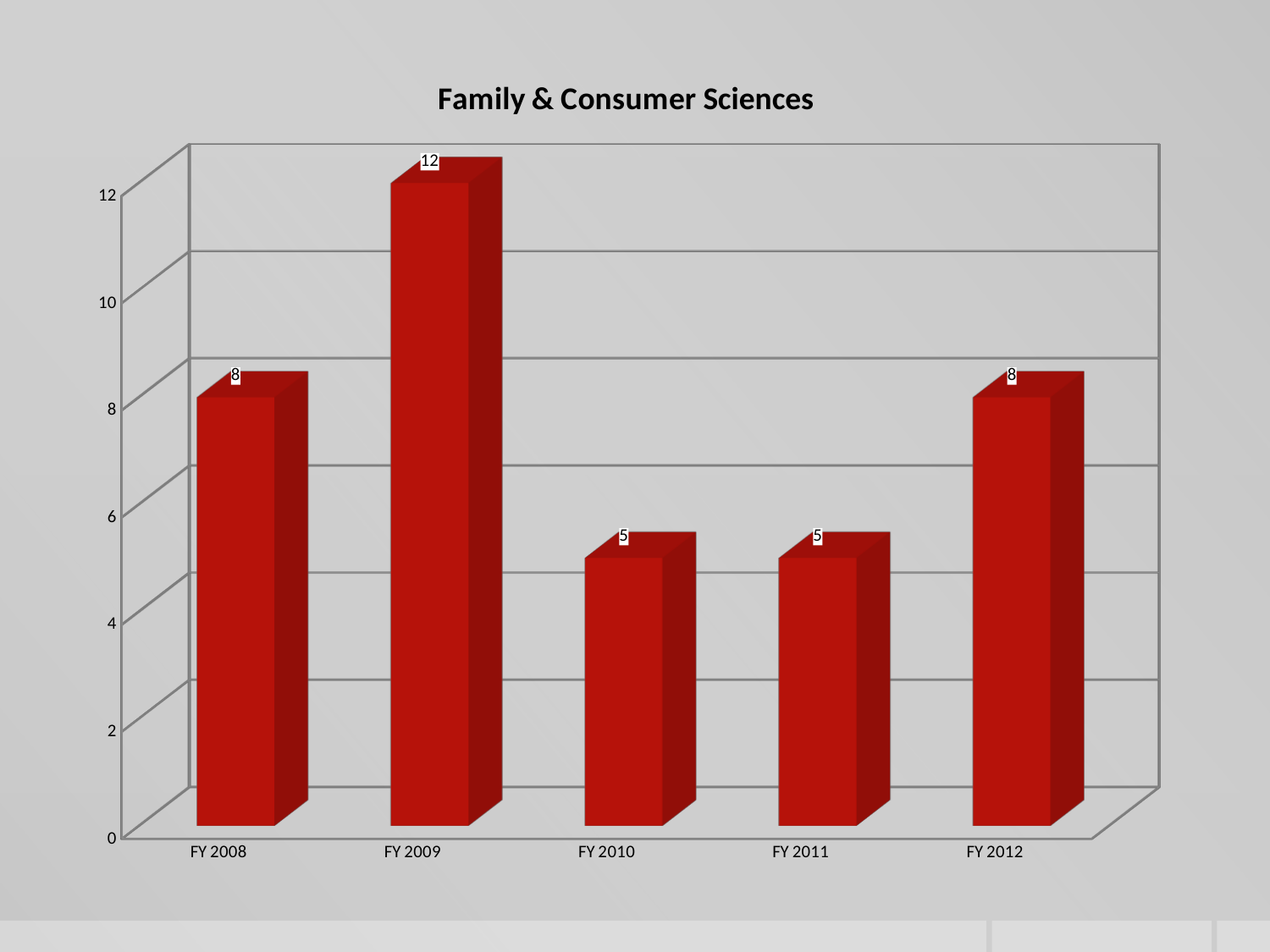
Which fiscal year has the highest value? FY 2009 Which is larger, the value for FY 2008 or the value for FY 2011? FY 2008 Is the value for FY 2009 greater or less than 10? greater What is the difference between the values for FY 2008 and FY 2010? 3 What is the value for FY 2010? 5 What is the value for FY 2009? 12 What is the title of the chart? Family & Consumer Sciences What kind of chart is shown on the slide? bar chart What is the value for FY 2012? 8 Do the values rise or fall from FY 2009 to FY 2010? fall How many fiscal years are shown on the chart? 5 What is the difference between the values for FY 2009 and FY 2011? 7